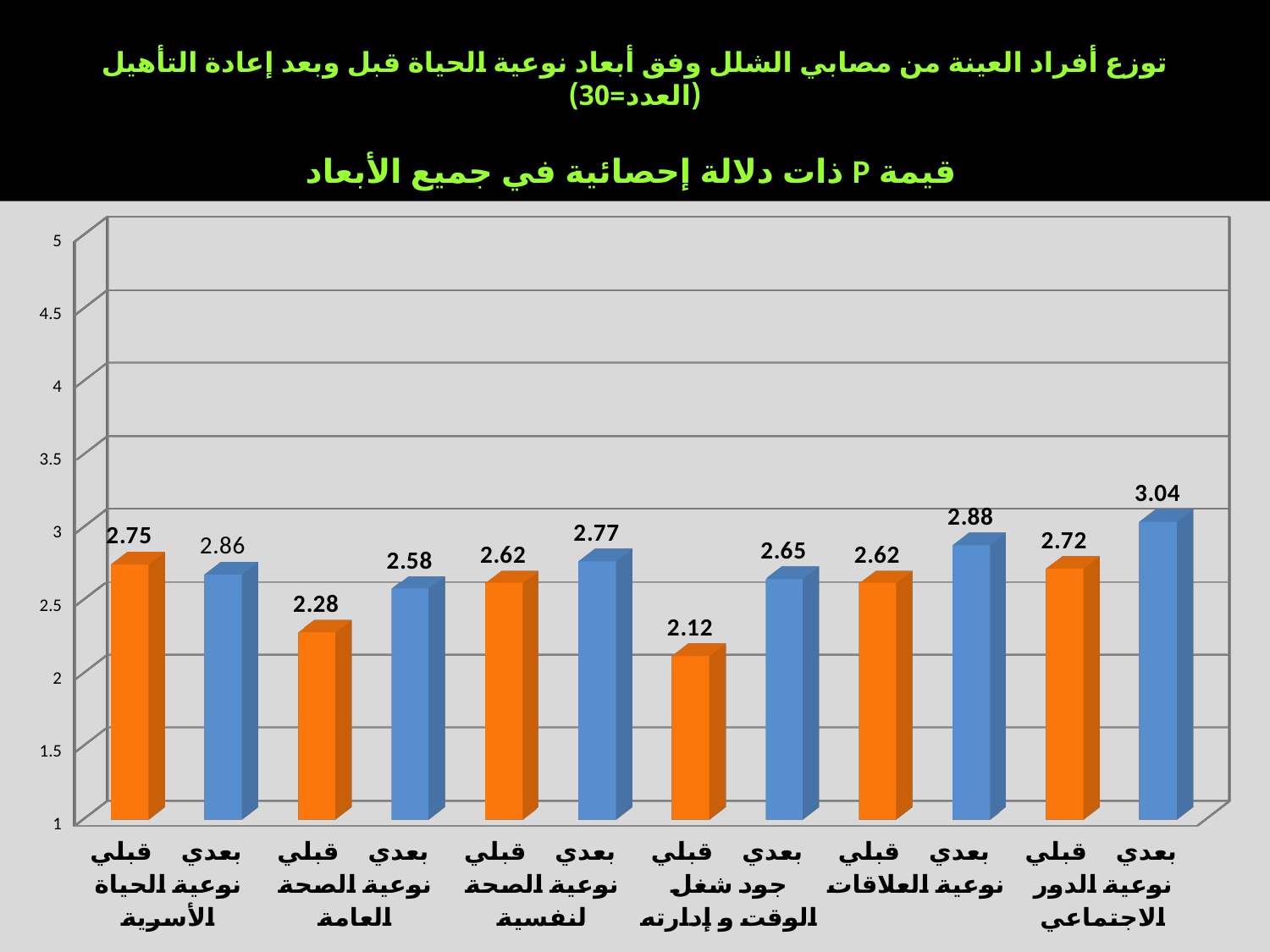
What colour are the 'قبلي' (before) bars? orange What kind of chart is shown on the slide? bar chart What is the value for 'قبلي نوعية الحياة الأسرية'? 2.75 Which category has the lowest value? قبلي جودة شغل الوقت و إدارته Is the value for 'بعدي نوعية الدور الاجتماعي' greater or less than 3? greater What is the difference between the values for 'بعدي نوعية الصحة العامة' and 'قبلي نوعية الصحة العامة'? 0.30 Which category has the highest value? بعدي نوعية الدور الاجتماعي What is the value for 'بعدي نوعية الدور الاجتماعي'? 3.04 Which is larger: the value for 'قبلي نوعية الصحة النفسية' or 'بعدي نوعية الصحة النفسية'? بعدي نوعية الصحة النفسية What is the value for 'قبلي جودة شغل الوقت و إدارته'? 2.12 How many bars are plotted in the chart? 12 What is the value for 'بعدي نوعية العلاقات'? 2.88